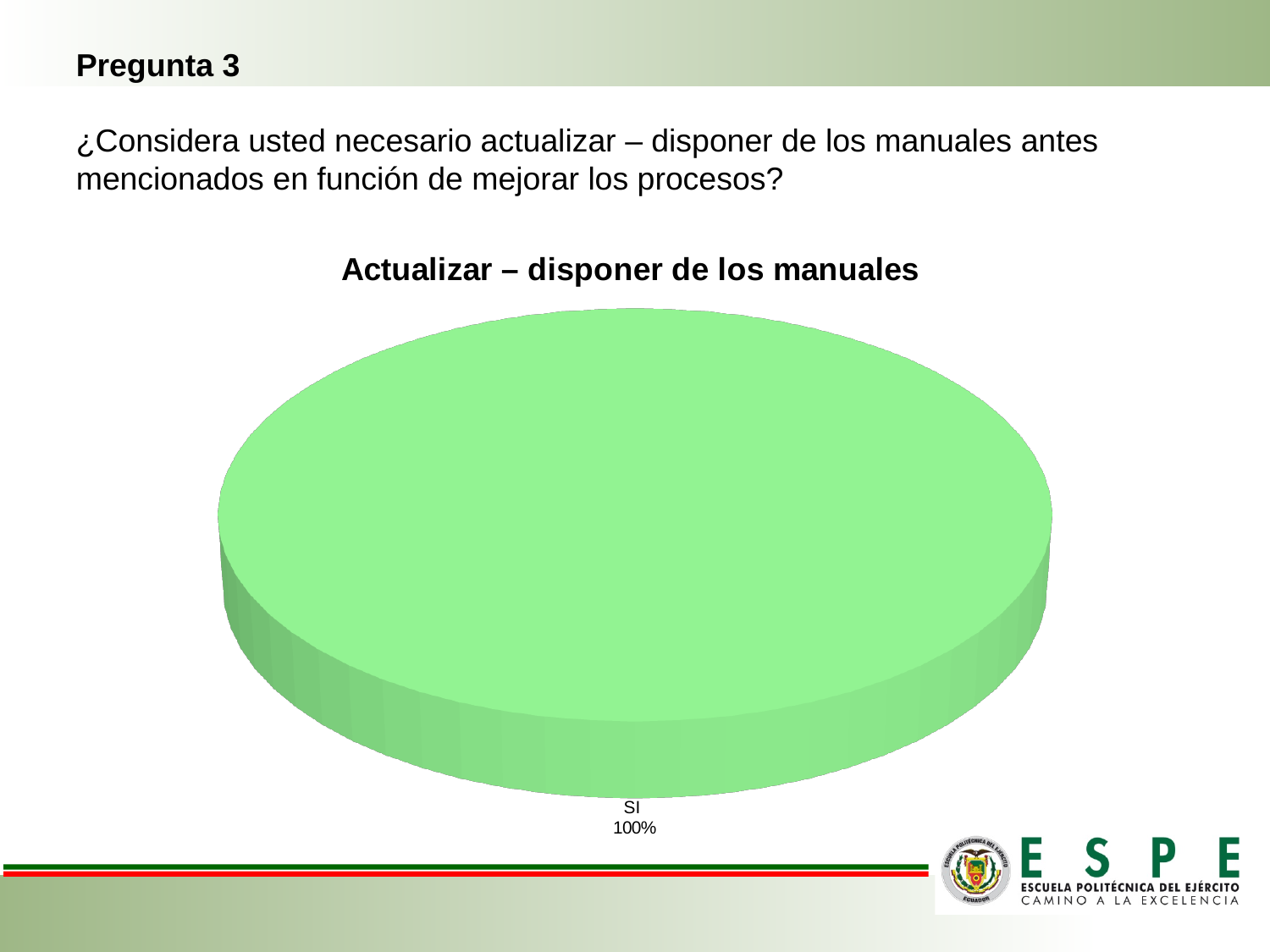
Is the value for SI greater or less than 50%? greater What is the title of the chart? Actualizar – disponer de los manuales What share of the pie does the SI slice represent? 100% How many slices does the pie chart have? 1 What colour is the SI slice of the pie chart? green What is the value shown for the SI category? 100% What kind of chart is shown on the slide? pie chart Which category is the largest in the pie chart? SI